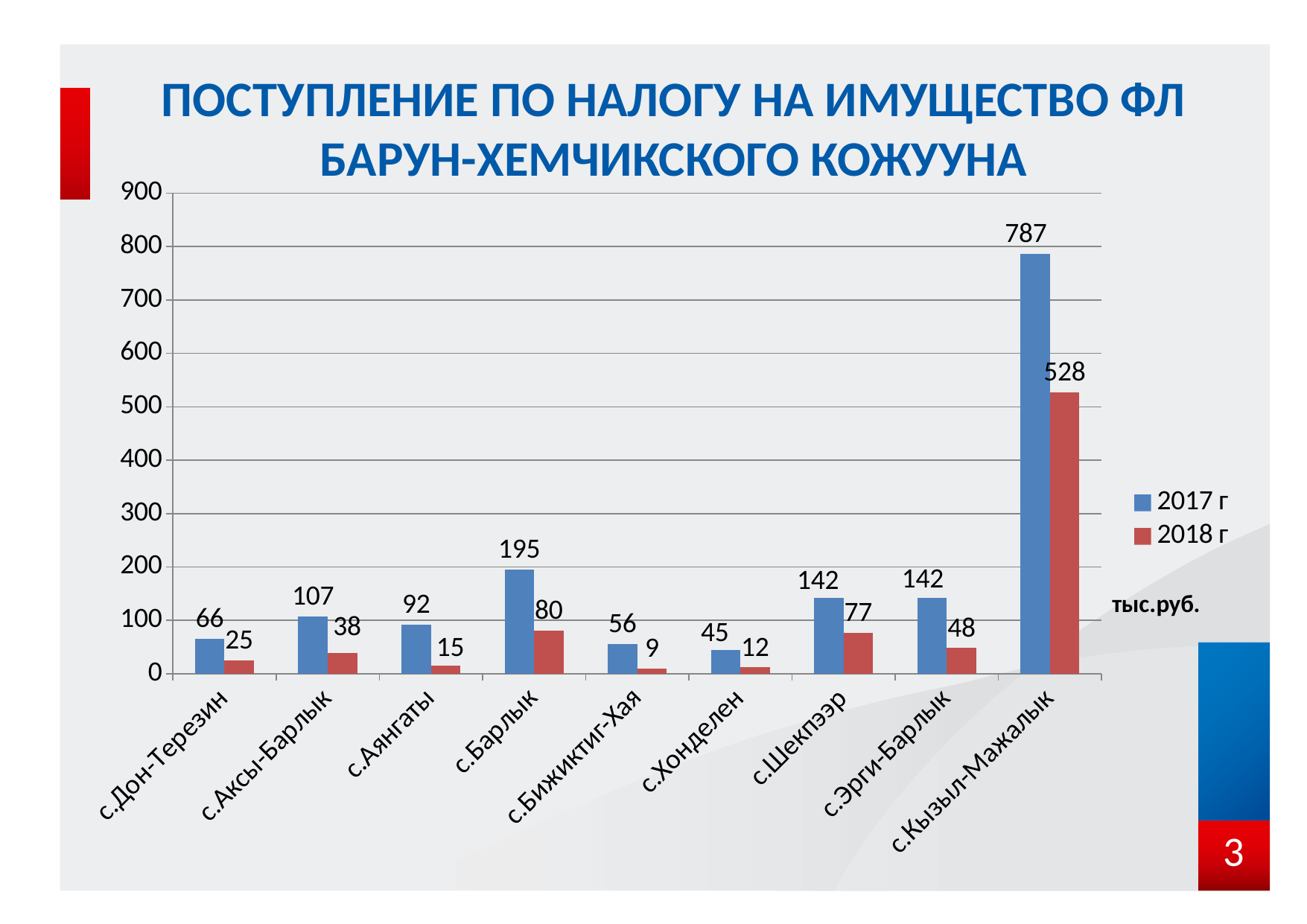
Which category has the highest 2018 г value? с.Кызыл-Мажалык Which is larger: the 2017 г value for с.Аксы-Барлык or the 2017 г value for с.Аянгаты? с.Аксы-Барлык What kind of chart is shown on the slide? bar chart What is the 2018 г value for с.Барлык? 80 What is the 2018 г value for с.Бижиктиг-Хая? 9 What is the 2018 г value for с.Шекпээр? 77 What is the 2017 г value for с.Кызыл-Мажалык? 787 What unit label is shown next to the chart? тыс.руб. What is the difference between the 2017 г and 2018 г values for с.Кызыл-Мажалык? 259 How many series does the legend list? 2 Which category has the lowest 2017 г value? с.Хонделен How many categories are shown on the x axis? 9